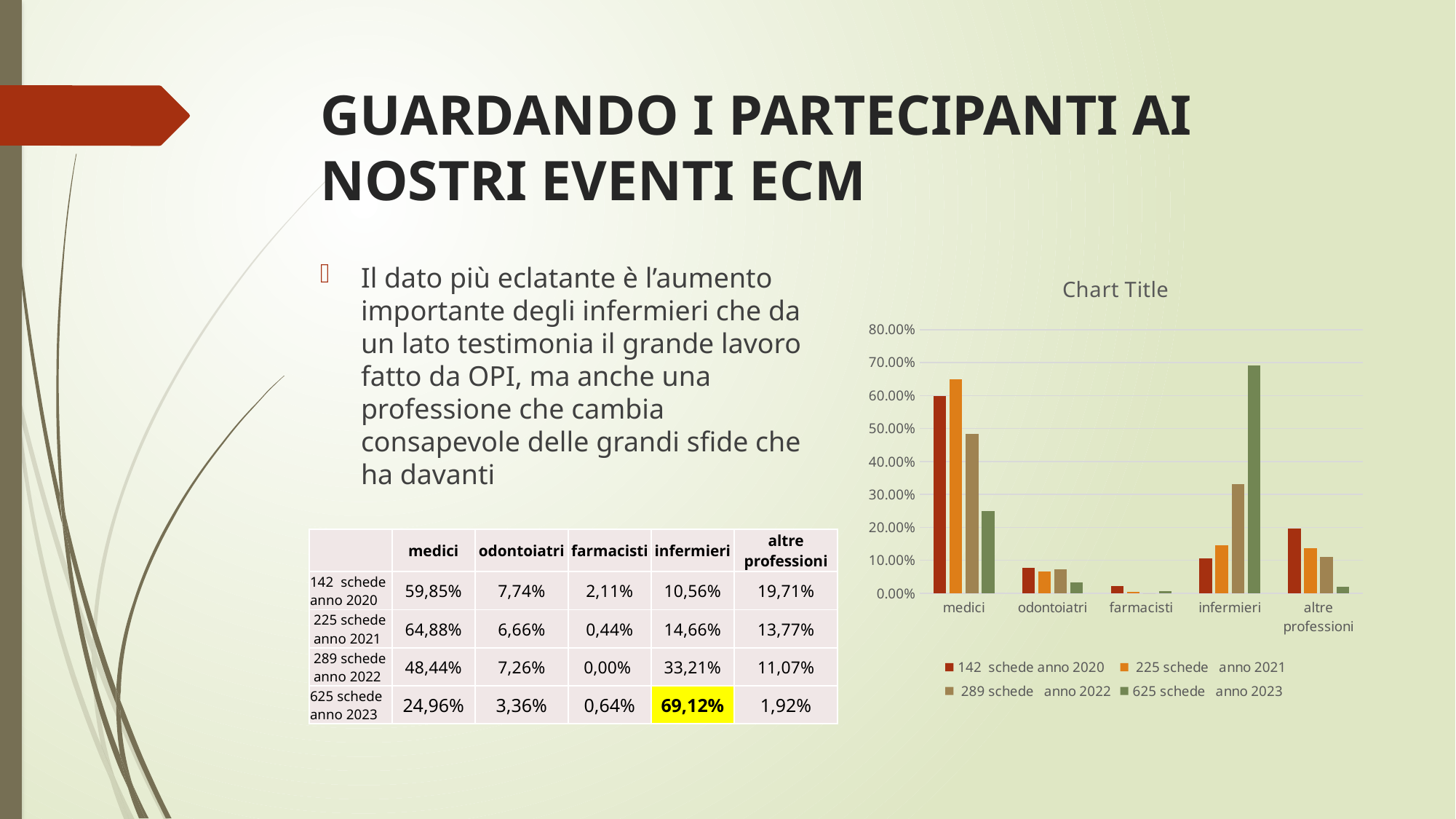
What is the difference between the infermieri values for 625 schede anno 2023 and 289 schede anno 2022? 35,91% Is the value for medici in the series 142 schede anno 2020 greater or less than 50.00%? greater What is the value for infermieri in the series 625 schede anno 2023? 69,12% Which category has the lowest value for the series 625 schede anno 2023? farmacisti How many series does the chart legend list? 4 What is the value for farmacisti in the series 289 schede anno 2022? 0,00% Is the value for infermieri in the series 289 schede anno 2022 greater or less than 40.00%? less How many categories are shown on the x axis of the chart? 5 What kind of chart is shown on the slide? bar chart Which category has the highest value for the series 625 schede anno 2023? infermieri What is the title of the chart? Chart Title For medici, which series has the larger value: 142 schede anno 2020 or 225 schede anno 2021? 225 schede anno 2021